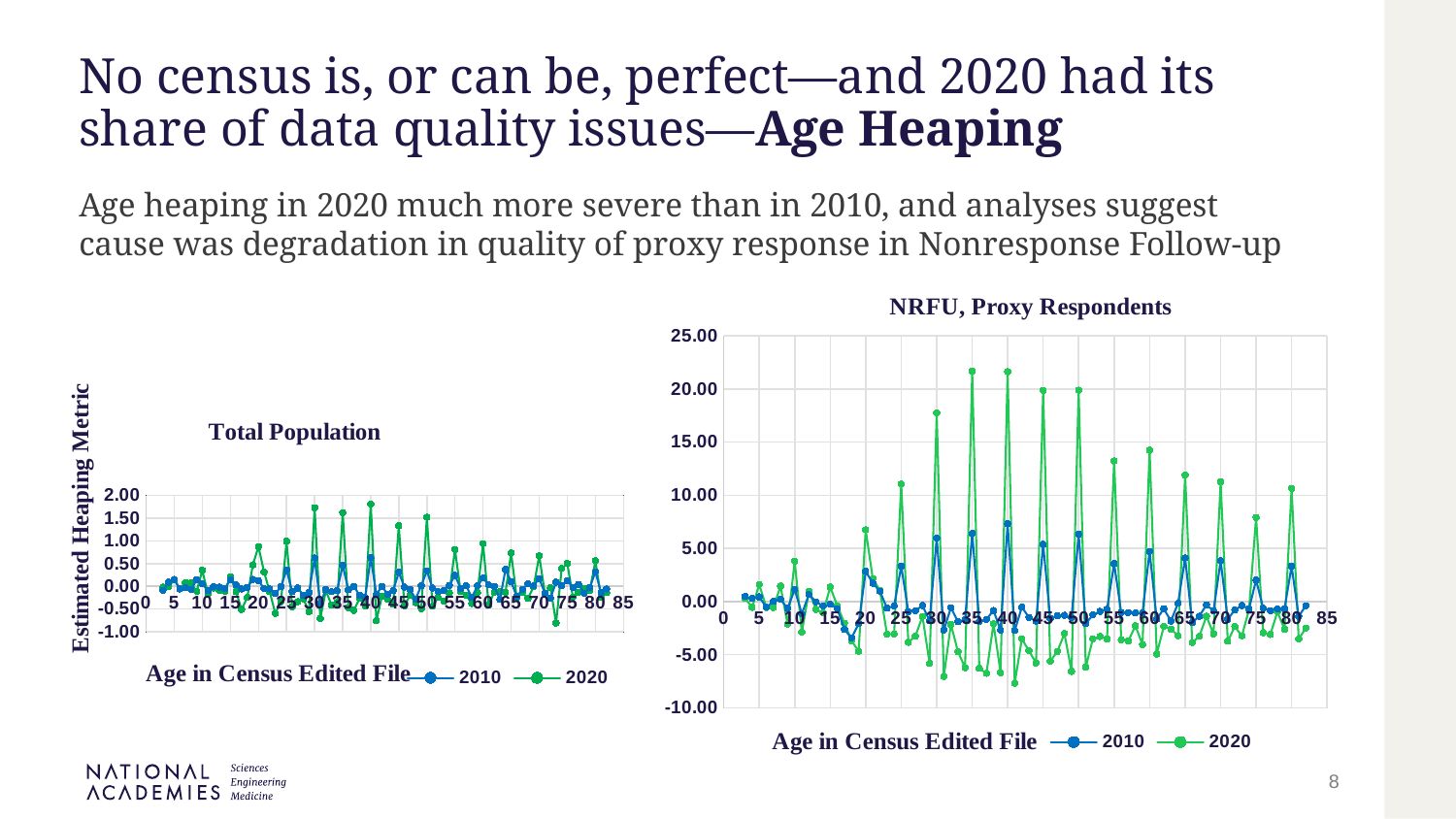
What is the x-axis label of the 'NRFU, Proxy Respondents' chart? Age in Census Edited File In the 'NRFU, Proxy Respondents' chart, is the 2020 value at age 30 greater or less than 15.00? greater What are the two series shown in the legend of the 'NRFU, Proxy Respondents' chart? 2010 and 2020 In the 'NRFU, Proxy Respondents' chart, is the 2020 value at age 35 greater or less than 20.00? greater In the 'Total Population' chart, is the 2020 value at age 20 greater or less than 0.50? greater What kind of chart is the 'NRFU, Proxy Respondents' chart? line chart In the 'NRFU, Proxy Respondents' chart, which series has the larger value at age 35, 2010 or 2020? 2020 How many series does the legend of the 'Total Population' chart list? 2 In the 'Total Population' chart, which series reaches the higher peak values, 2010 or 2020? 2020